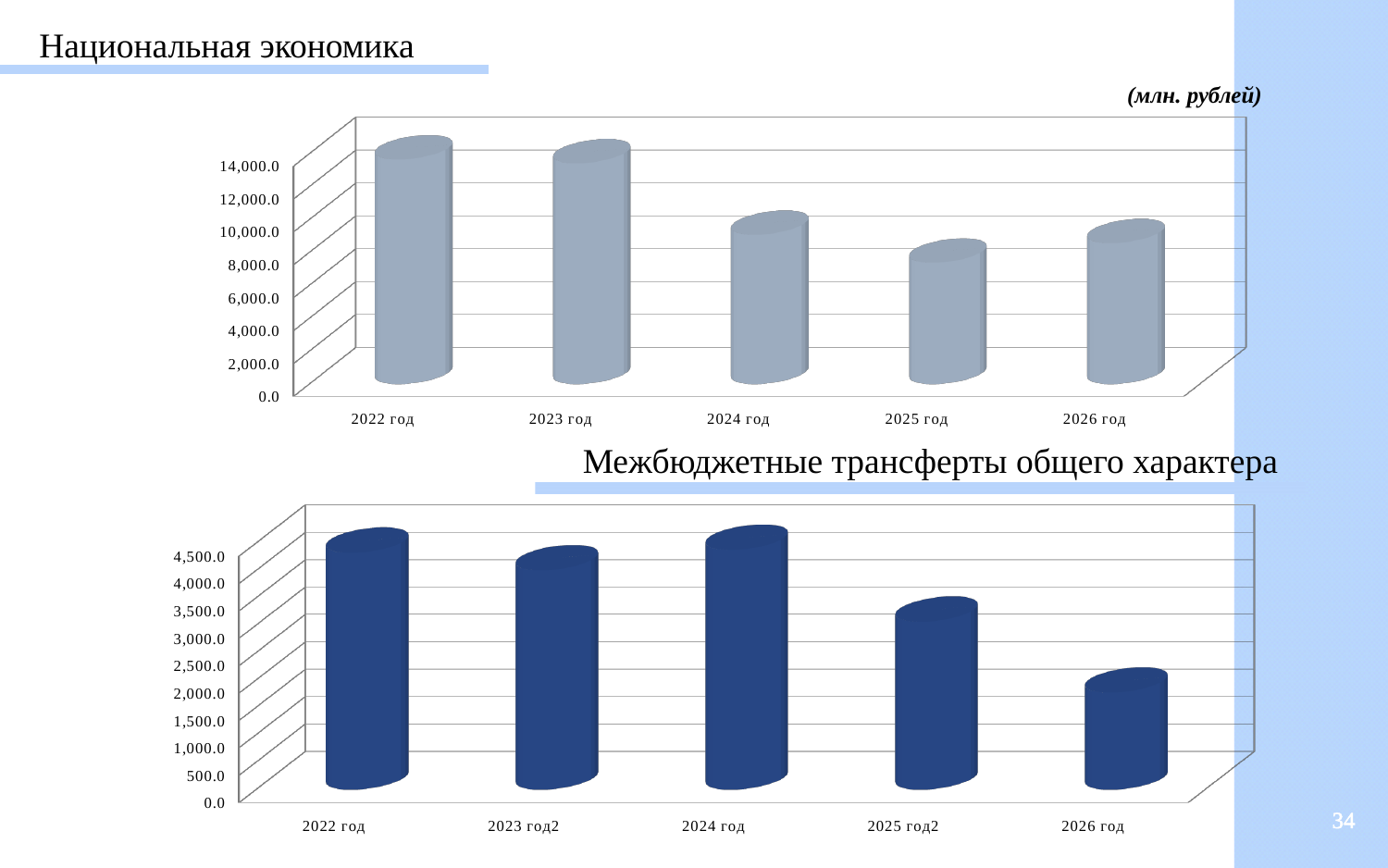
On the bottom chart "Межбюджетные трансферты общего характера", is the value for 2026 год greater or less than 3,000.0? less On the top chart "Национальная экономика", is the value for 2022 год greater or less than 10,000.0? greater On the bottom chart "Межбюджетные трансферты общего характера", which is larger, the value for 2025 год2 or 2026 год? 2025 год2 On the top chart "Национальная экономика", which year has the lowest value? 2025 год On the bottom chart "Межбюджетные трансферты общего характера", which category has the lowest value? 2026 год On the top chart "Национальная экономика", which is larger, the value for 2024 год or 2025 год? 2024 год How many years are shown on the top chart "Национальная экономика"? 5 What is the title of the bottom chart? Межбюджетные трансферты общего характера What kind of chart is the top chart titled "Национальная экономика"? bar chart What unit is stated for the values on the slide? млн. рублей On the top chart "Национальная экономика", is the value for 2025 год greater or less than 10,000.0? less On the bottom chart "Межбюджетные трансферты общего характера", do the values overall rise or fall from 2022 год to 2026 год? fall